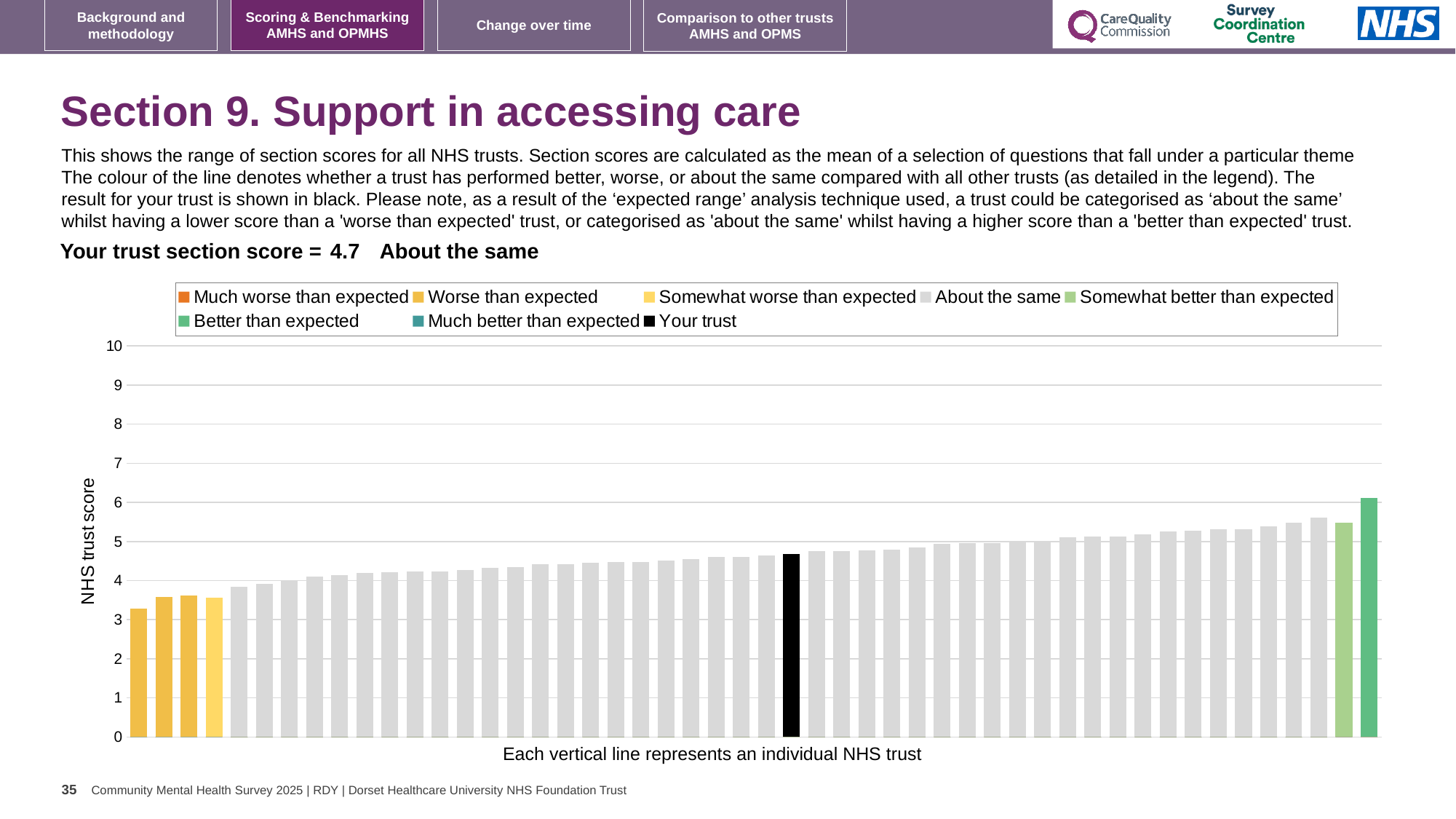
Is the value of the tallest bar greater or less than 7? less Is the value of the lowest bar greater or less than 4? less What is the section score for your trust shown on the slide? 4.7 Is the value for your trust (the black bar) greater or less than 4? greater What kind of chart is shown on the slide? bar chart What is the label on the vertical axis of the chart? NHS trust score Which performance category is your trust placed in for this section? About the same What colour is the bar representing your trust? black Do the bar values rise or fall moving from left to right along the x axis? rise How many entries does the chart legend list? 8 What is the highest value shown on the vertical axis? 10